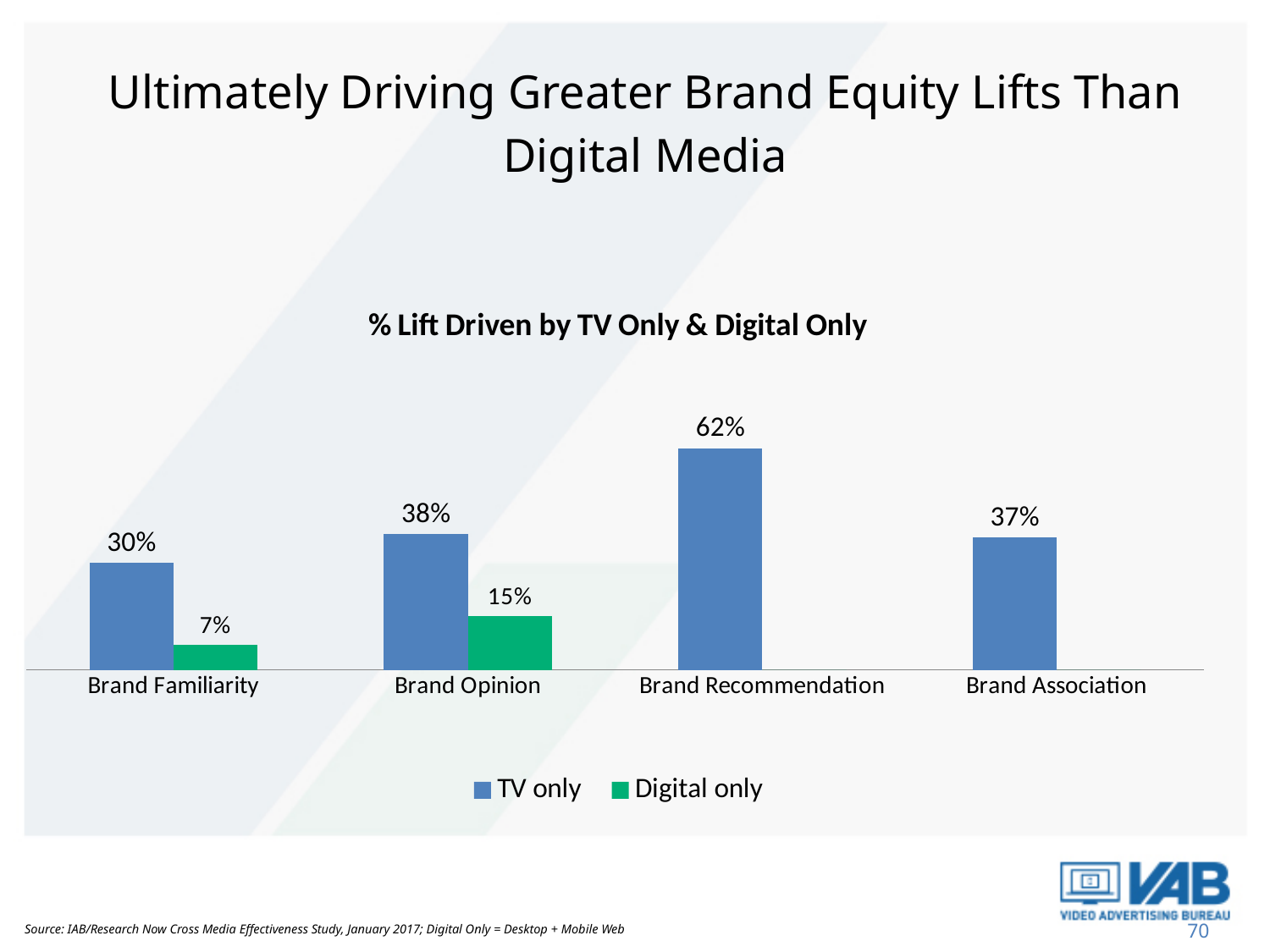
Which category has the lowest TV only % lift? Brand Familiarity What is the title of the chart? % Lift Driven by TV Only & Digital Only How many series does the legend list? 2 Which is larger: the TV only % lift for Brand Familiarity or the Digital only % lift for Brand Familiarity? TV only What is the difference between the TV only % lift for Brand Recommendation and Brand Association? 25% How many categories are shown on the x axis? 4 What is the Digital only % lift for Brand Opinion? 15% Which category has the highest TV only % lift? Brand Recommendation What is the difference between the TV only and Digital only % lift for Brand Opinion? 23% What kind of chart is shown on the slide? Bar chart What is the TV only % lift for Brand Association? 37% What is the TV only % lift for Brand Familiarity? 30%